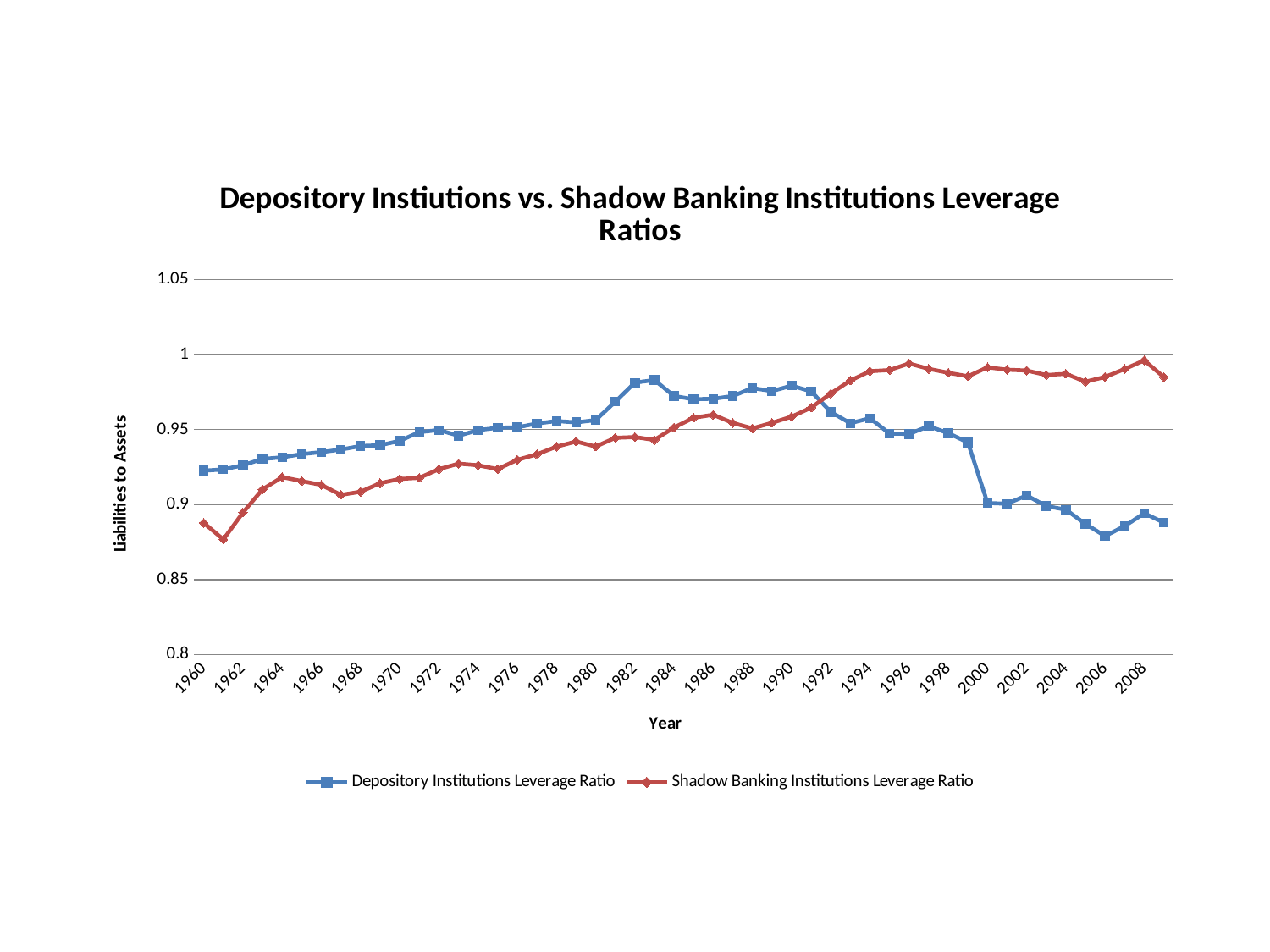
In 2008, which series has the higher value, Depository Institutions Leverage Ratio or Shadow Banking Institutions Leverage Ratio? Shadow Banking Institutions Leverage Ratio Is the Depository Institutions Leverage Ratio in 1982 greater or less than 0.95? greater How many series does the legend list? 2 In 1960, which series has the higher value, Depository Institutions Leverage Ratio or Shadow Banking Institutions Leverage Ratio? Depository Institutions Leverage Ratio What is the label on the vertical axis? Liabilities to Assets Is the Shadow Banking Institutions Leverage Ratio in 1996 greater or less than 1? less Is the Shadow Banking Institutions Leverage Ratio in 1961 greater or less than 0.9? less Does the Shadow Banking Institutions Leverage Ratio generally rise or fall from 1960 to 2008? rise What kind of chart is shown on the slide? Line chart What is the title of the chart? Depository Instiutions vs. Shadow Banking Institutions Leverage Ratios